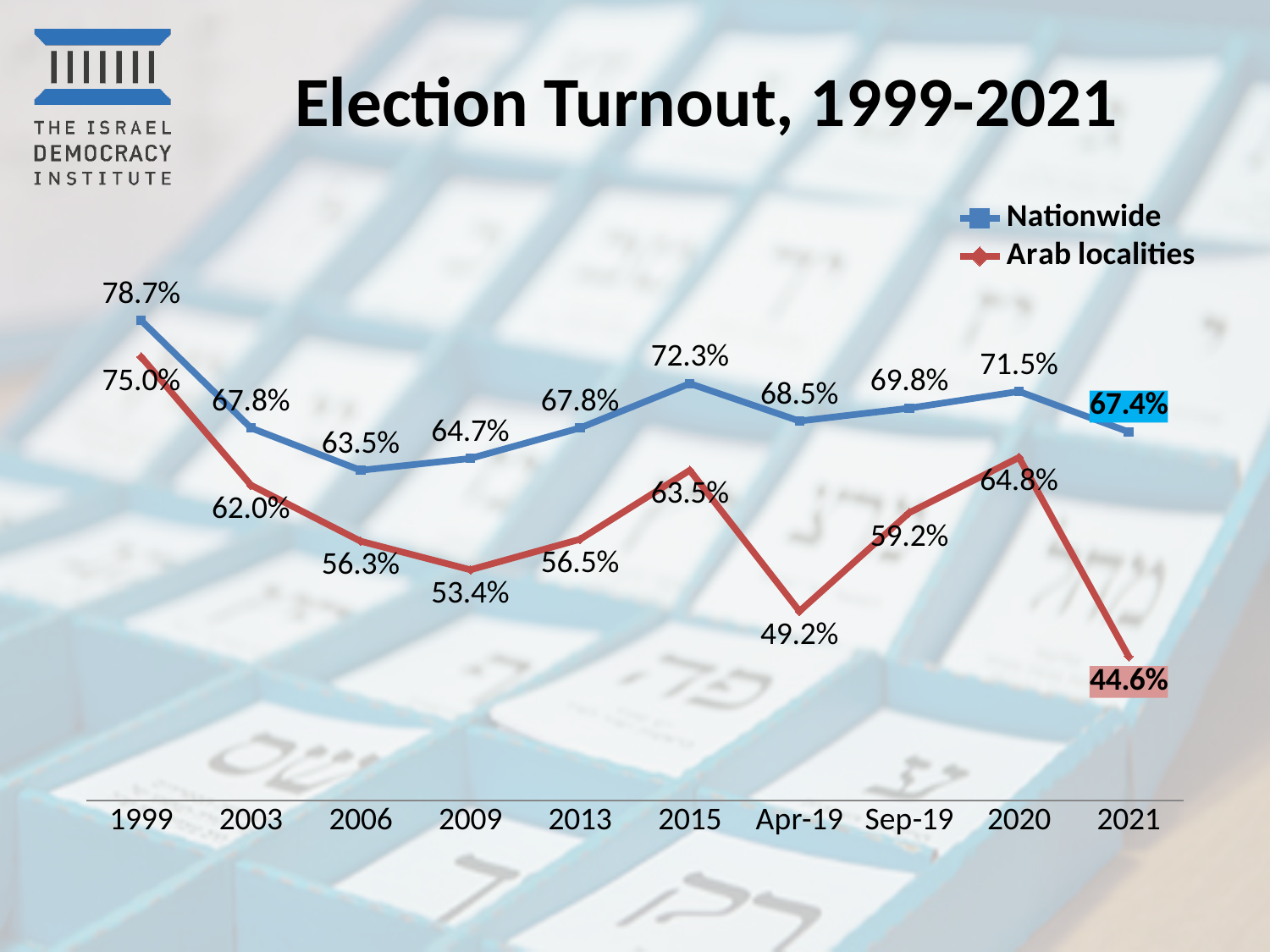
Did the turnout in Arab localities rise or fall between 2020 and 2021? Fall What is the difference between the Nationwide turnout and the Arab localities turnout in 2021? 22.8 percentage points What is the title of the chart? Election Turnout, 1999-2021 How many series does the legend list? 2 In which election was the turnout in Arab localities highest? 1999 How many elections (points) are plotted along the x axis? 10 What type of chart is shown on the slide? Line chart What was the Nationwide turnout in 1999? 78.7% In which election was the Nationwide turnout lowest? 2006 What was the turnout in Arab localities in 2021? 44.6% Which was higher in 2020: the Nationwide turnout or the turnout in Arab localities? Nationwide What was the turnout in Arab localities in Apr-19? 49.2%